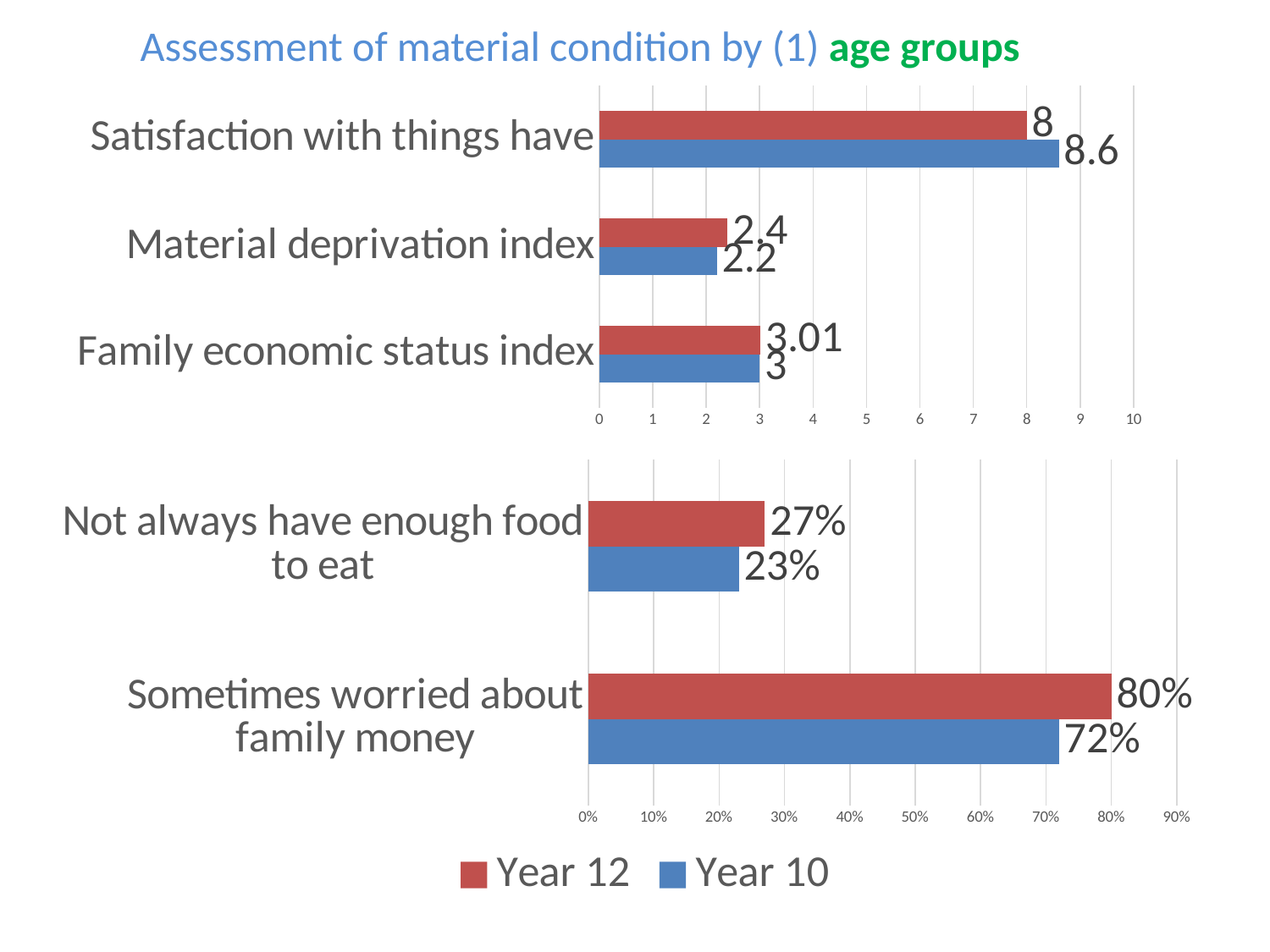
In the top chart, what is the Year 12 value for Material deprivation index? 2.4 In the top chart, which category has the highest Year 12 value? Satisfaction with things have In the top chart, what is the difference between the Year 10 and Year 12 values for Satisfaction with things have? 0.6 In the top chart, what is the Year 12 value for Family economic status index? 3.01 In the top chart, which category has the lowest Year 10 value? Material deprivation index In the bottom chart, which is larger for Not always have enough food to eat: the Year 12 value or the Year 10 value? Year 12 In the bottom chart, what percentage of Year 10 students do not always have enough food to eat? 23% In the top chart, what is the Year 10 value for Satisfaction with things have? 8.6 What type of chart is the bottom chart? Bar chart In the bottom chart, what is the difference between the Year 12 and Year 10 values for Sometimes worried about family money? 8% In the bottom chart, what percentage of Year 12 students sometimes worried about family money? 80% How many series does the legend list? 2